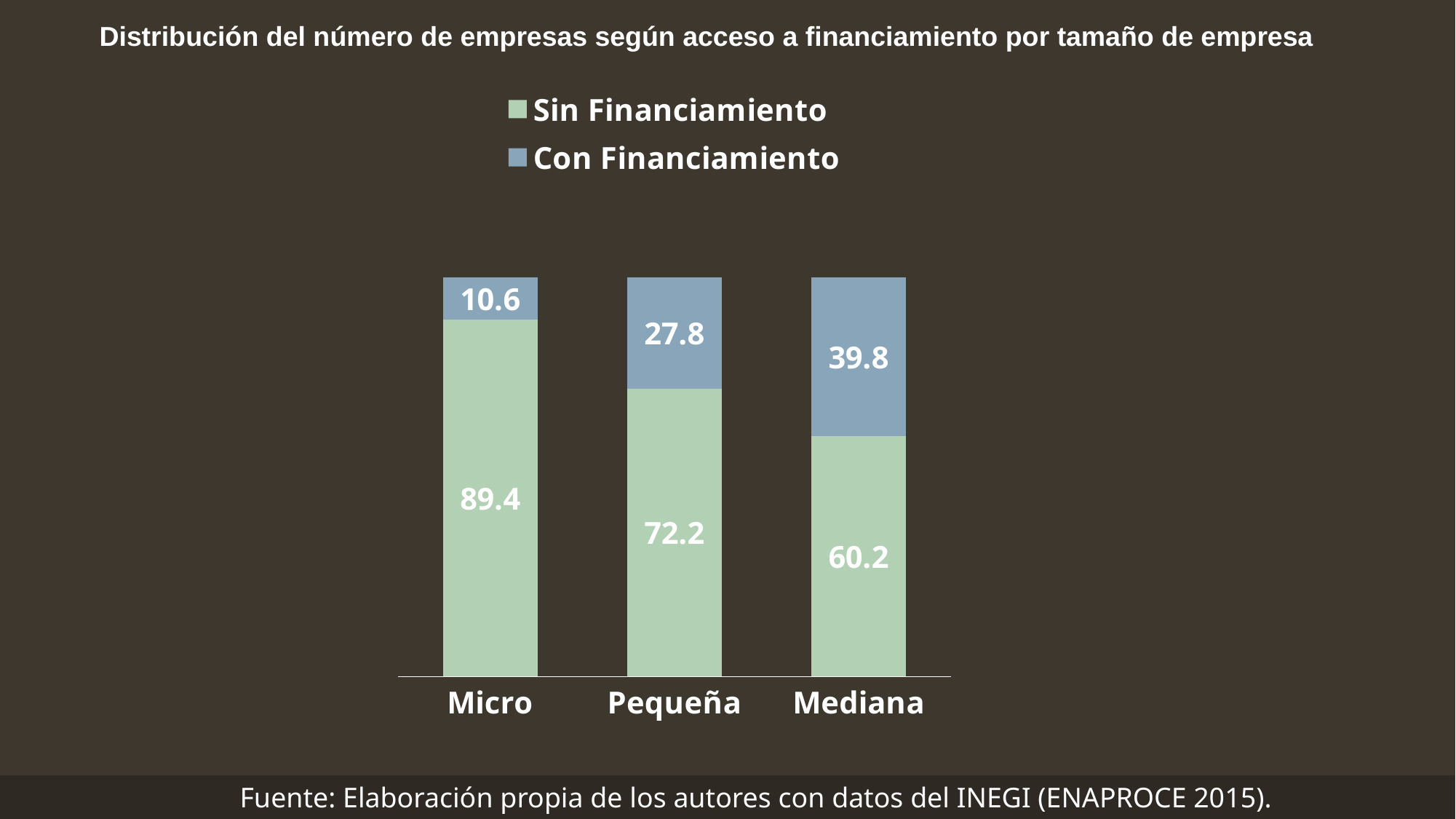
Which category has the lowest Sin Financiamiento value? Mediana What is the Sin Financiamiento value for Micro? 89.4 Which is larger: the Con Financiamiento value for Pequeña or for Micro? Pequeña What is the total of the stacked bar for Mediana? 100 How many series does the legend list? 2 Do the Con Financiamiento values rise or fall from Micro to Mediana? Rise How many categories are shown on the x axis? 3 What is the Con Financiamiento value for Mediana? 39.8 Which category has the highest Con Financiamiento value? Mediana What kind of chart is shown on the slide? Stacked bar chart What is the difference between the Sin Financiamiento values for Micro and Pequeña? 17.2 What is the Con Financiamiento value for Pequeña? 27.8